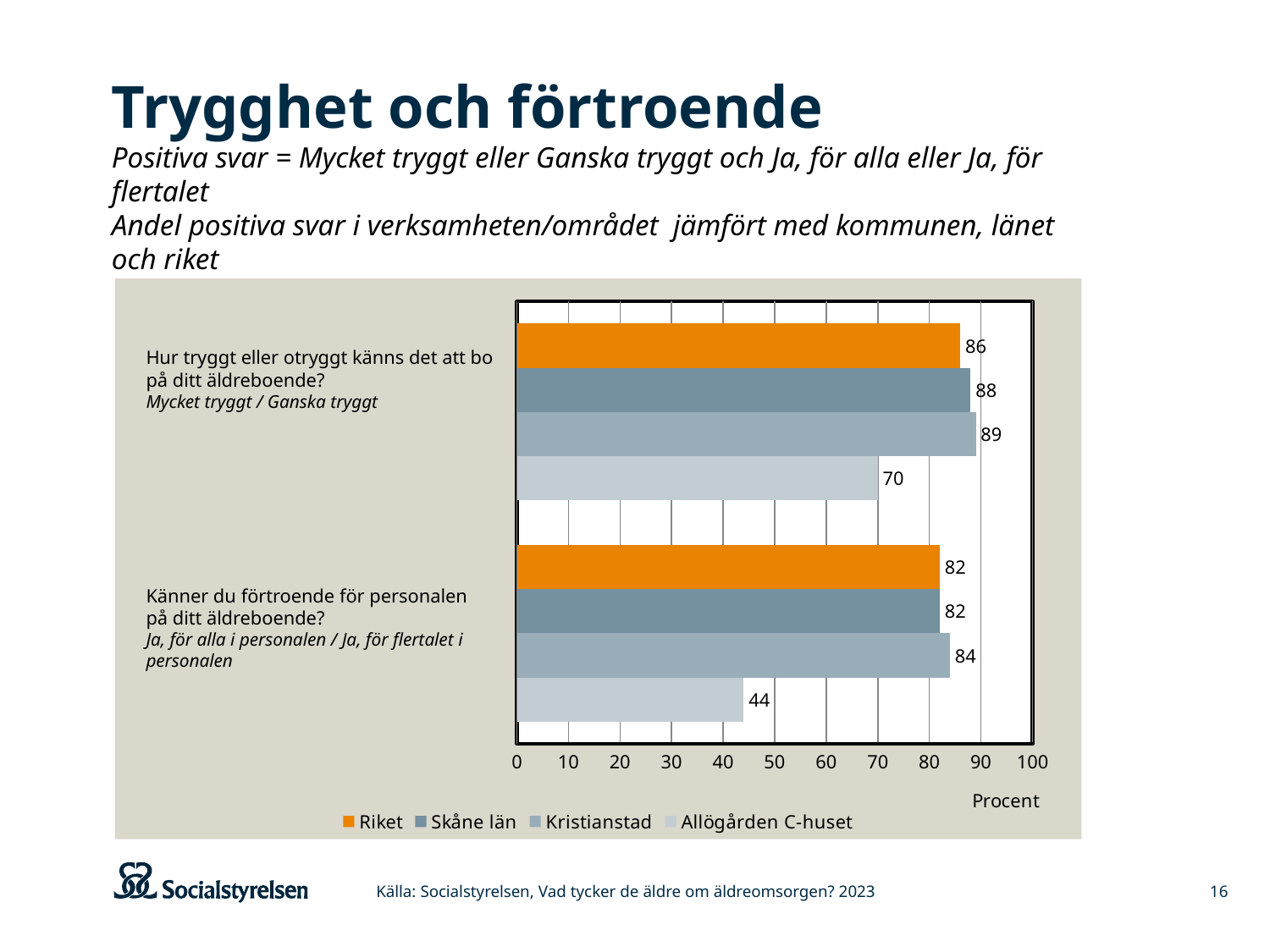
Which series has the highest value on the question "Hur tryggt eller otryggt känns det att bo på ditt äldreboende?"? Kristianstad Which series has the lowest value on the question "Känner du förtroende för personalen på ditt äldreboende?"? Allögården C-huset What is the value for Allögården C-huset on the question "Känner du förtroende för personalen på ditt äldreboende?"? 44 How many series does the legend list? 4 What is the value for Allögården C-huset on the question "Hur tryggt eller otryggt känns det att bo på ditt äldreboende?"? 70 Which is larger on the question "Hur tryggt eller otryggt känns det att bo på ditt äldreboende?": Riket or Allögården C-huset? Riket What is the difference between Kristianstad and Allögården C-huset on the question "Känner du förtroende för personalen på ditt äldreboende?"? 40 What is the difference between Skåne län and Allögården C-huset on the question "Hur tryggt eller otryggt känns det att bo på ditt äldreboende?"? 18 What type of chart is shown on the slide? bar chart What is the value for Riket on the question "Hur tryggt eller otryggt känns det att bo på ditt äldreboende?"? 86 What is the label of the x axis? Procent What is the value for Kristianstad on the question "Känner du förtroende för personalen på ditt äldreboende?"? 84